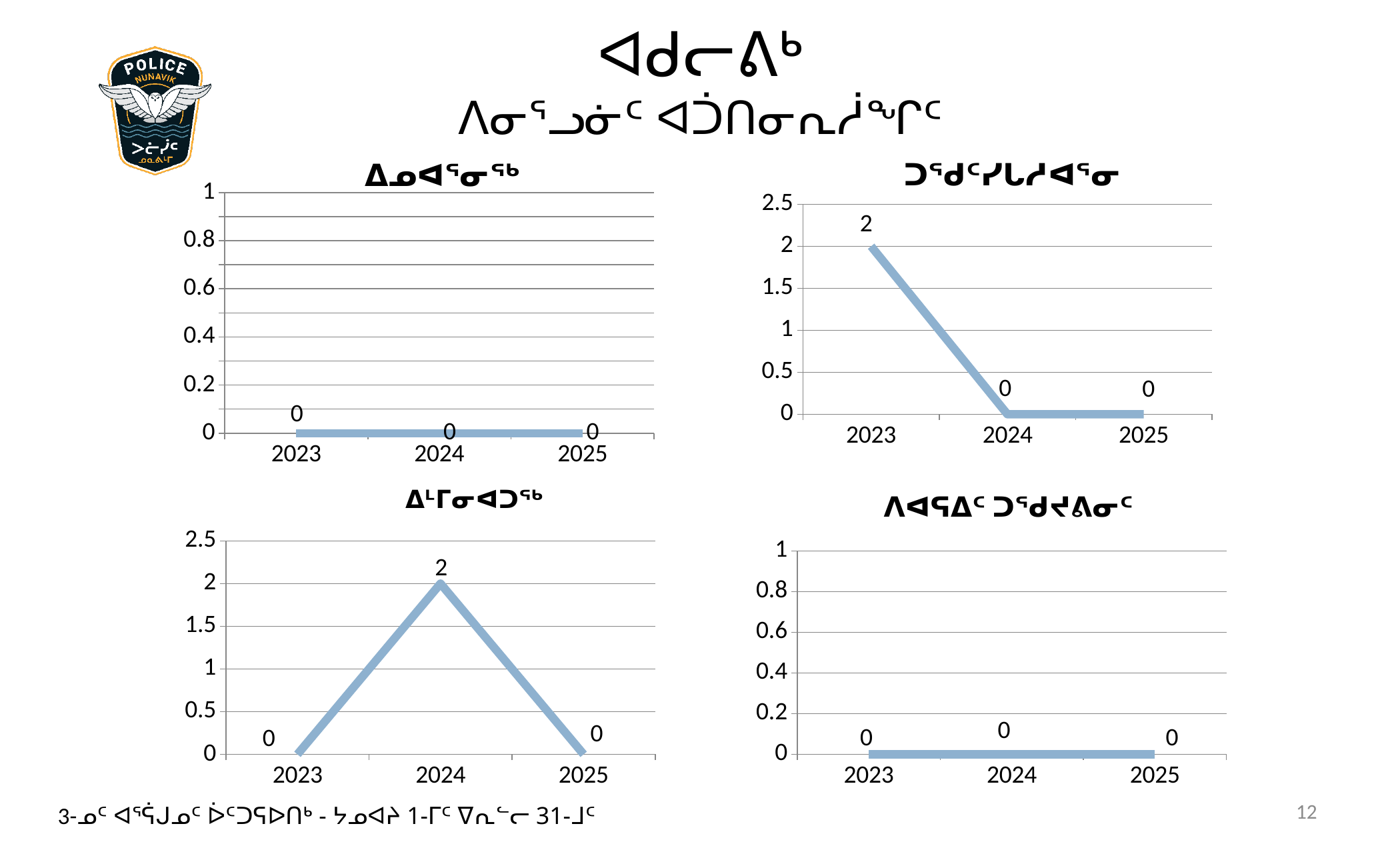
In the top-right chart, what is the difference between the values for 2023 and 2025? 2 In the top-right chart, what is the value for 2023? 2 In the bottom-left chart, what is the value for 2024? 2 What kind of chart is the bottom-left chart? line chart In the bottom-left chart, which year has the highest value? 2024 In the top-left chart, what is the value for 2024? 0 How many charts are on the slide? 4 In the top-right chart, what is the value for 2024? 0 In the top-right chart, which year has the highest value? 2023 In the bottom-left chart, which is larger, the value for 2023 or the value for 2024? 2024 In the bottom-left chart, what is the value for 2025? 0 In the bottom-right chart, what is the value for 2025? 0